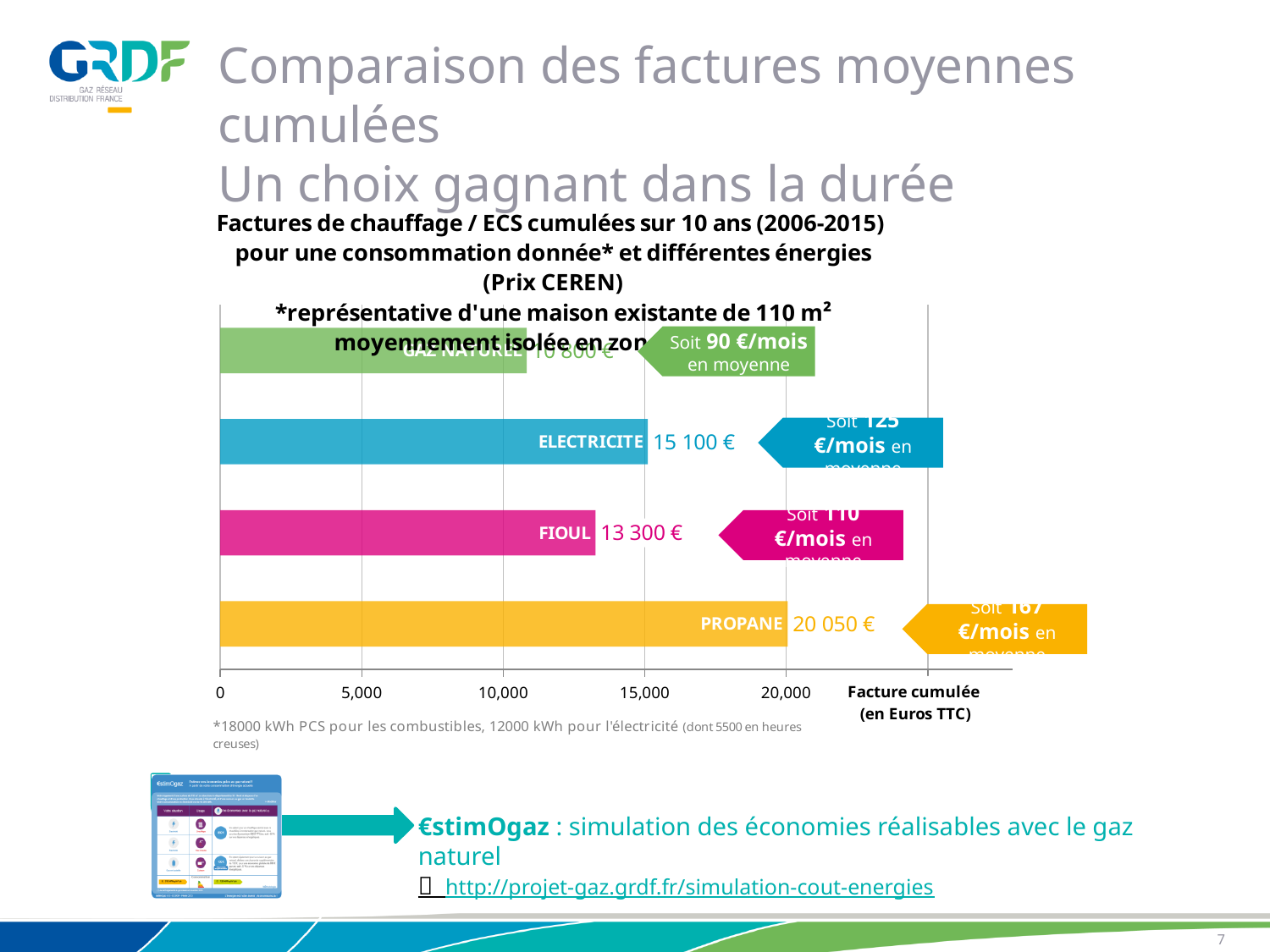
What is the difference between the cumulative bills for ELECTRICITE and FIOUL? 1 800 € What type of chart is shown on the slide? bar chart What is the difference between the cumulative bills for PROPANE and ELECTRICITE? 4 950 € What is the cumulative bill value shown for FIOUL? 13 300 € How many energy categories are plotted in the chart? 4 What is the cumulative bill value shown for PROPANE? 20 050 € What is the cumulative bill value shown for ELECTRICITE? 15 100 € Is the cumulative bill for GAZ NATUREL greater or less than 15,000? less Which energy has the lowest cumulative bill in the chart? GAZ NATUREL Which has a larger cumulative bill, FIOUL or ELECTRICITE? ELECTRICITE Which energy has the highest cumulative bill in the chart? PROPANE What average monthly amount is indicated for PROPANE? 167 €/mois